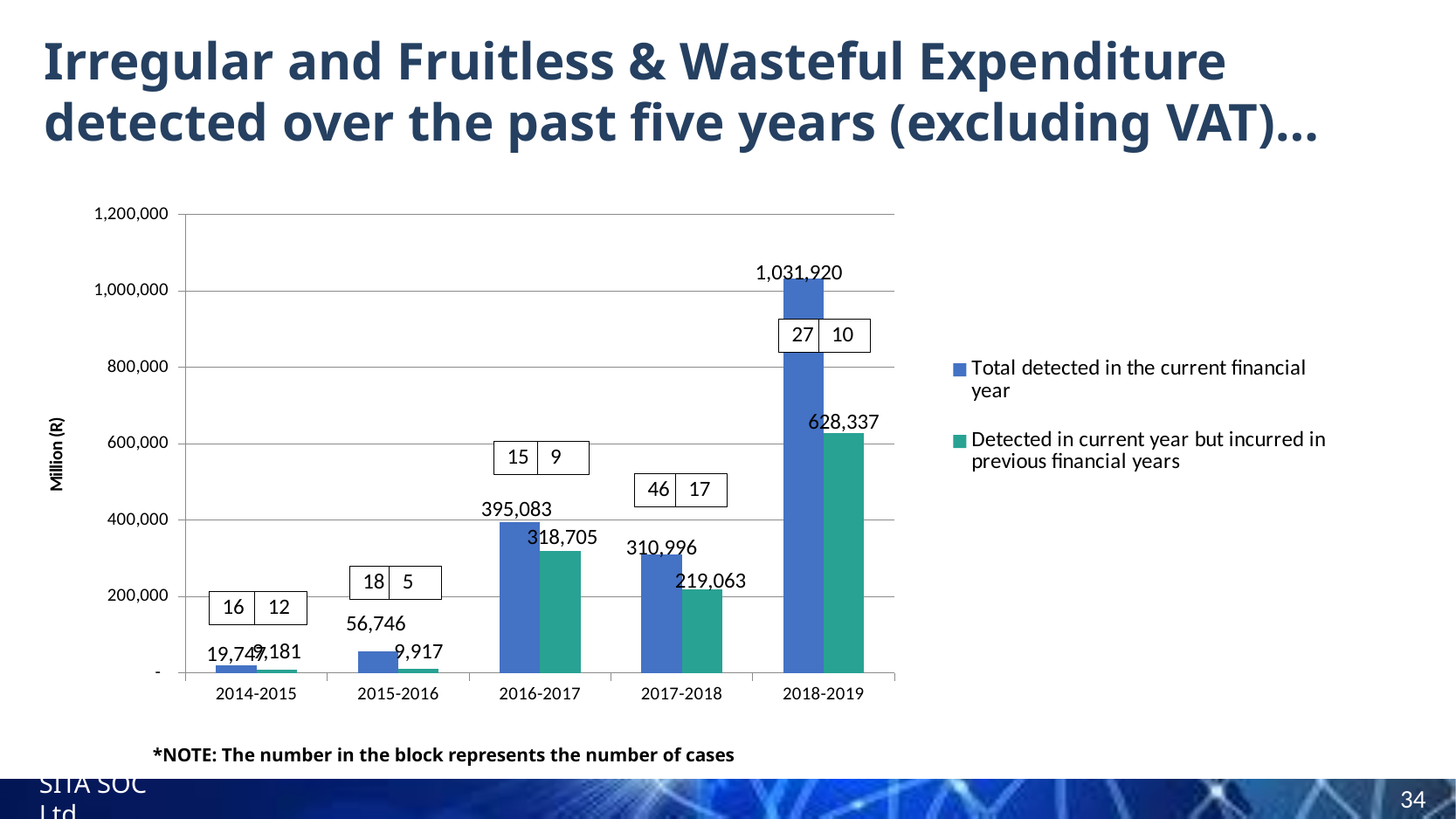
How many series does the legend list? 2 Which financial year has the lowest value for 'Total detected in the current financial year'? 2014-2015 What is the value of 'Total detected in the current financial year' for 2015-2016? 56,746 How many financial years are shown on the x axis? 5 What kind of chart is shown on the slide? bar chart For 2018-2019, what is the difference between 'Total detected in the current financial year' and 'Detected in current year but incurred in previous financial years'? 403,583 What is the value of 'Detected in current year but incurred in previous financial years' for 2017-2018? 219,063 What is the value of 'Detected in current year but incurred in previous financial years' for 2016-2017? 318,705 Which financial year has the highest value for 'Total detected in the current financial year'? 2018-2019 Which is larger for 'Total detected in the current financial year': 2016-2017 or 2017-2018? 2016-2017 What is the value of 'Total detected in the current financial year' for 2018-2019? 1,031,920 Is the value for 'Detected in current year but incurred in previous financial years' in 2018-2019 greater or less than 600,000? greater